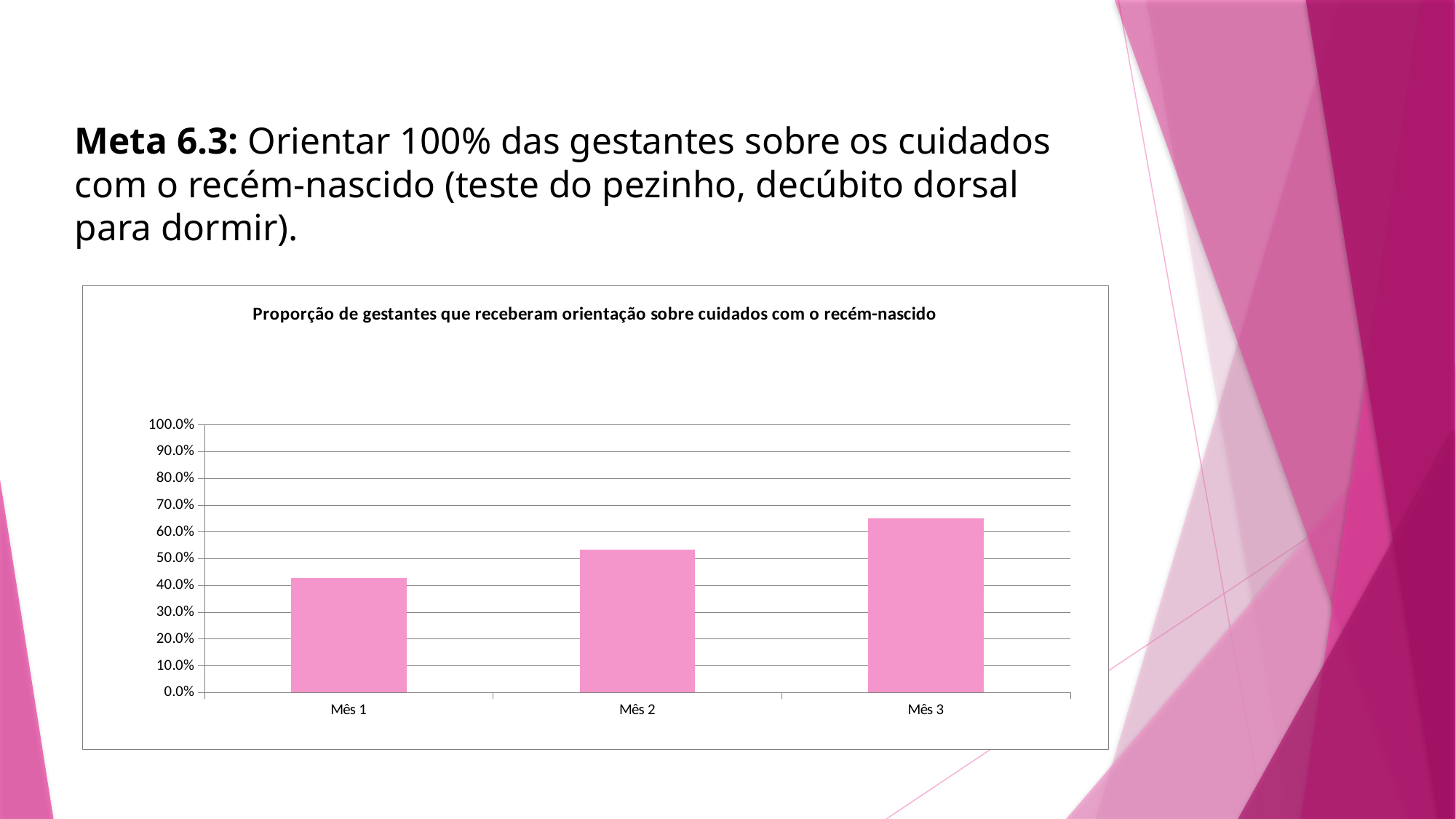
What kind of chart is shown on the slide? bar chart Which month has the highest value in the chart? Mês 3 Which month has the lowest value in the chart? Mês 1 How many categories are shown on the x axis of the chart? 3 Is the value for Mês 3 greater or less than 60.0%? greater Which is larger, the value for Mês 2 or the value for Mês 3? Mês 3 What is the title of the chart? Proporção de gestantes que receberam orientação sobre cuidados com o recém-nascido Which is larger, the value for Mês 1 or the value for Mês 2? Mês 2 Do the values rise or fall from Mês 1 to Mês 3? rise Is the value for Mês 3 greater or less than 70.0%? less Is the value for Mês 1 greater or less than 50.0%? less